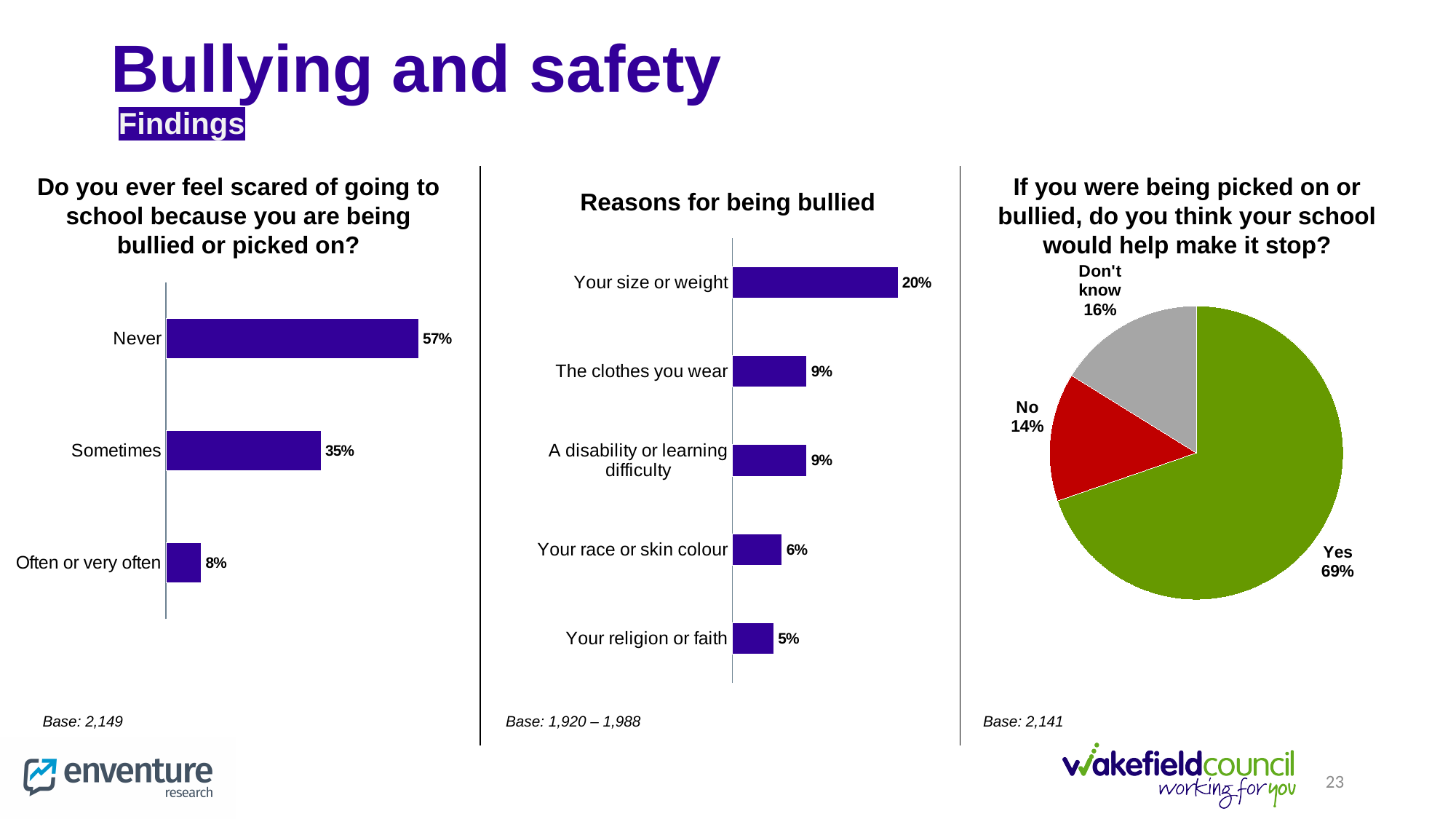
What kind of chart is the middle chart 'Reasons for being bullied'? Bar chart In the left chart 'Do you ever feel scared of going to school because you are being bullied or picked on?', how many categories are shown? 3 In the middle chart 'Reasons for being bullied', which reason has the lowest value? Your religion or faith In the middle chart 'Reasons for being bullied', what is the value for Your size or weight? 20% In the left chart 'Do you ever feel scared of going to school because you are being bullied or picked on?', what is the value for Never? 57% In the right chart 'If you were being picked on or bullied, do you think your school would help make it stop?', what is the difference between Don't know and No? 2% In the left chart 'Do you ever feel scared of going to school because you are being bullied or picked on?', what is the difference between Never and Sometimes? 22% In the right chart 'If you were being picked on or bullied, do you think your school would help make it stop?', what share of the pie is Yes? 69% In the middle chart 'Reasons for being bullied', which is larger: Your race or skin colour or The clothes you wear? The clothes you wear In the middle chart 'Reasons for being bullied', how many reasons are listed? 5 In the left chart 'Do you ever feel scared of going to school because you are being bullied or picked on?', which category has the lowest value? Often or very often In the right chart 'If you were being picked on or bullied, do you think your school would help make it stop?', what colour is the Yes slice? Green